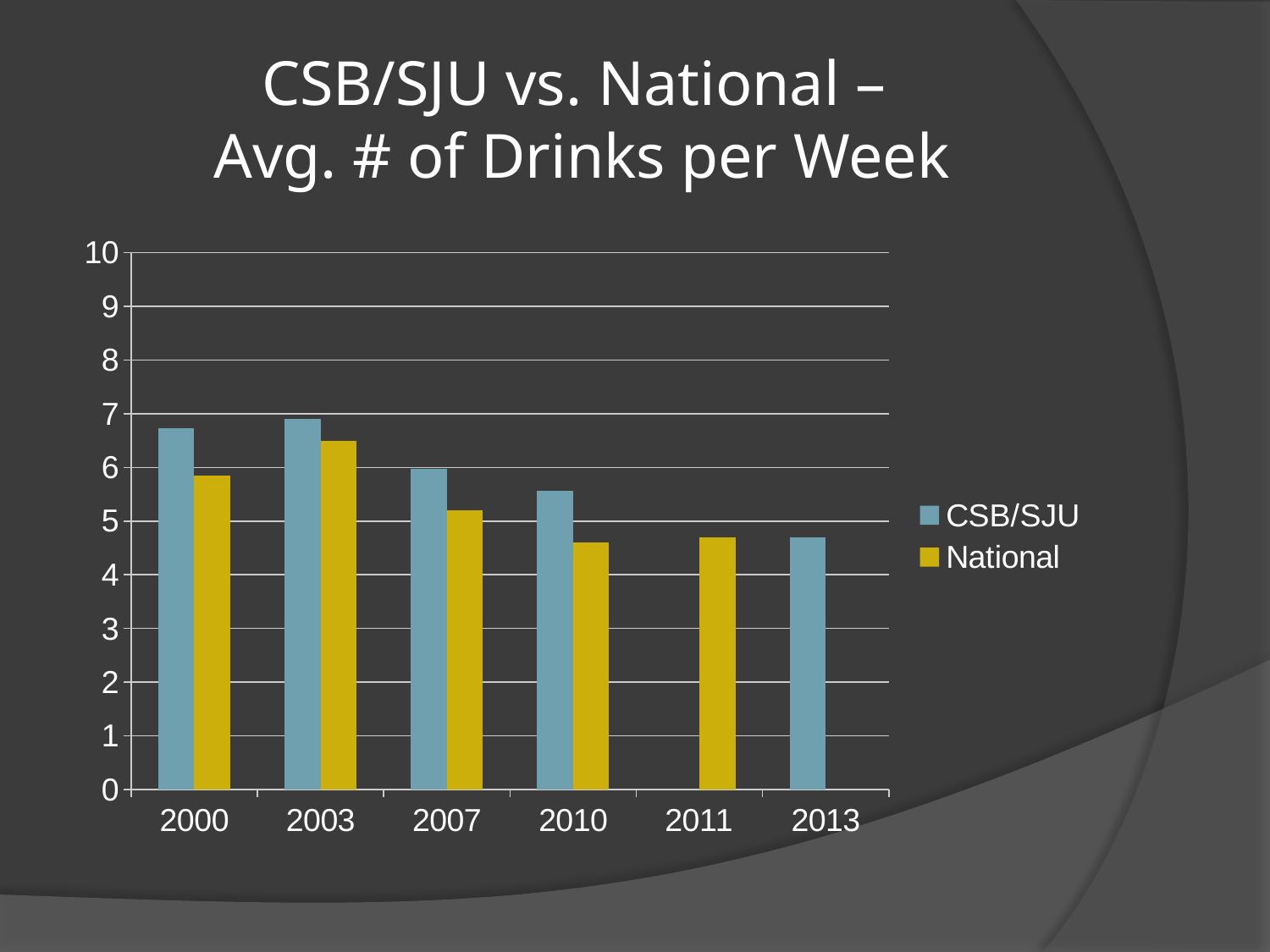
Do the CSB/SJU values generally rise or fall from 2000 to 2013? fall What kind of chart is shown on the slide? bar chart Which year has the highest National value? 2003 Which series is shown in yellow? National Is the CSB/SJU value for 2013 greater or less than 5? less In 2007, which is larger, the CSB/SJU value or the National value? CSB/SJU How many series does the legend list? 2 How many years are shown on the x axis? 6 Is the CSB/SJU value for 2000 greater or less than 6? greater Is the National value for 2010 greater or less than 5? less In 2000, which is larger, the CSB/SJU value or the National value? CSB/SJU Which year has the lowest CSB/SJU value? 2013